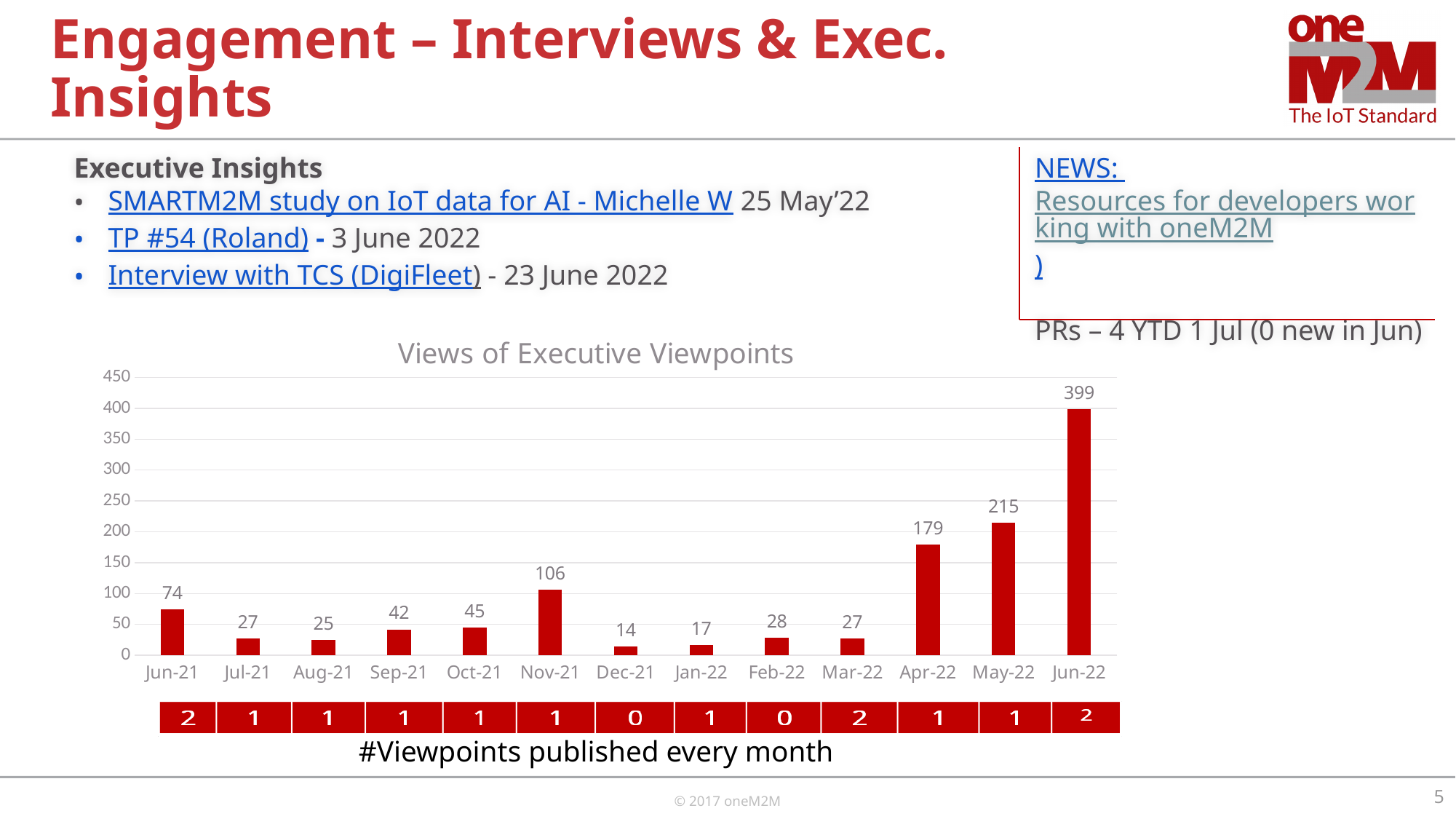
What is the difference between the values for Jun-22 and May-22 in the Views of Executive Viewpoints chart? 184 What is the value for Nov-21 in the Views of Executive Viewpoints chart? 106 Is the value for May-22 in the Views of Executive Viewpoints chart greater or less than 200? greater How many months are shown on the x axis of the Views of Executive Viewpoints chart? 13 What is the value for Dec-21 in the Views of Executive Viewpoints chart? 14 What is the value for Jun-22 in the Views of Executive Viewpoints chart? 399 Which is larger in the Views of Executive Viewpoints chart, the value for Jun-21 or the value for Oct-21? Jun-21 Which month has the highest value in the Views of Executive Viewpoints chart? Jun-22 What is the difference between the values for Apr-22 and Mar-22 in the Views of Executive Viewpoints chart? 152 What is the title of the chart on the slide? Views of Executive Viewpoints Which month has the lowest value in the Views of Executive Viewpoints chart? Dec-21 What kind of chart is the Views of Executive Viewpoints chart? bar chart